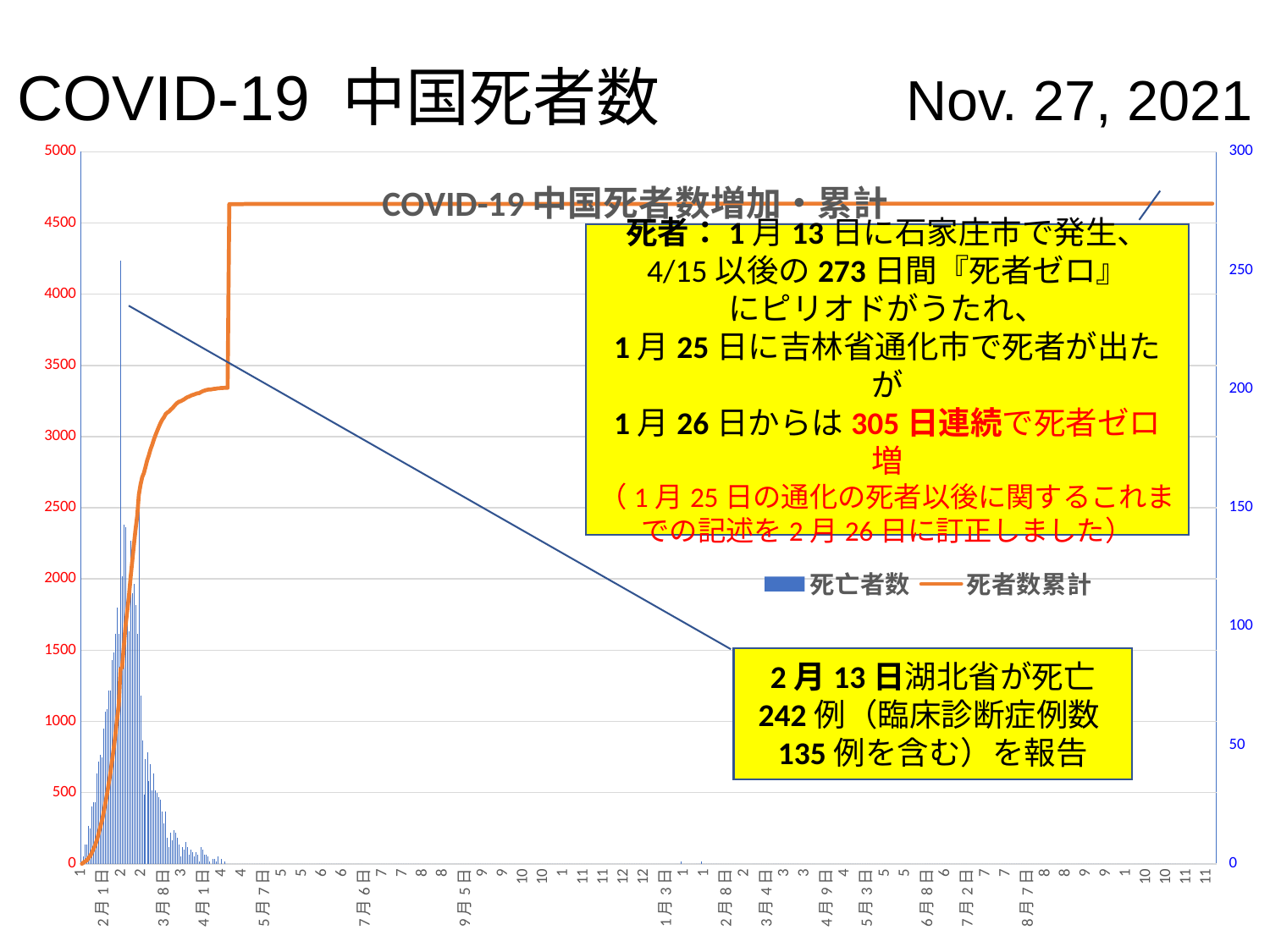
Which series is drawn as an orange line? 死者数累計 What is the maximum value shown on the left vertical axis? 5000 What kind of chart is shown on the slide? A combination bar and line chart Does the 死者数累計 line rise or fall from the start of the x axis to the point of its sharp jump? rise Just before the sharp vertical jump in the 死者数累計 line, is its value greater or less than 3500 on the left axis? less Is the final value of the 死者数累計 line greater or less than 5000 on the left axis? less How many series does the chart legend list? 2 What is the title of the chart? COVID-19 中国死者数増加・累計 Just before the sharp vertical jump in the 死者数累計 line, is its value greater or less than 3000 on the left axis? greater After its sharp jump, does the 死者数累計 line rise, fall, or stay flat along the rest of the x axis? stay flat